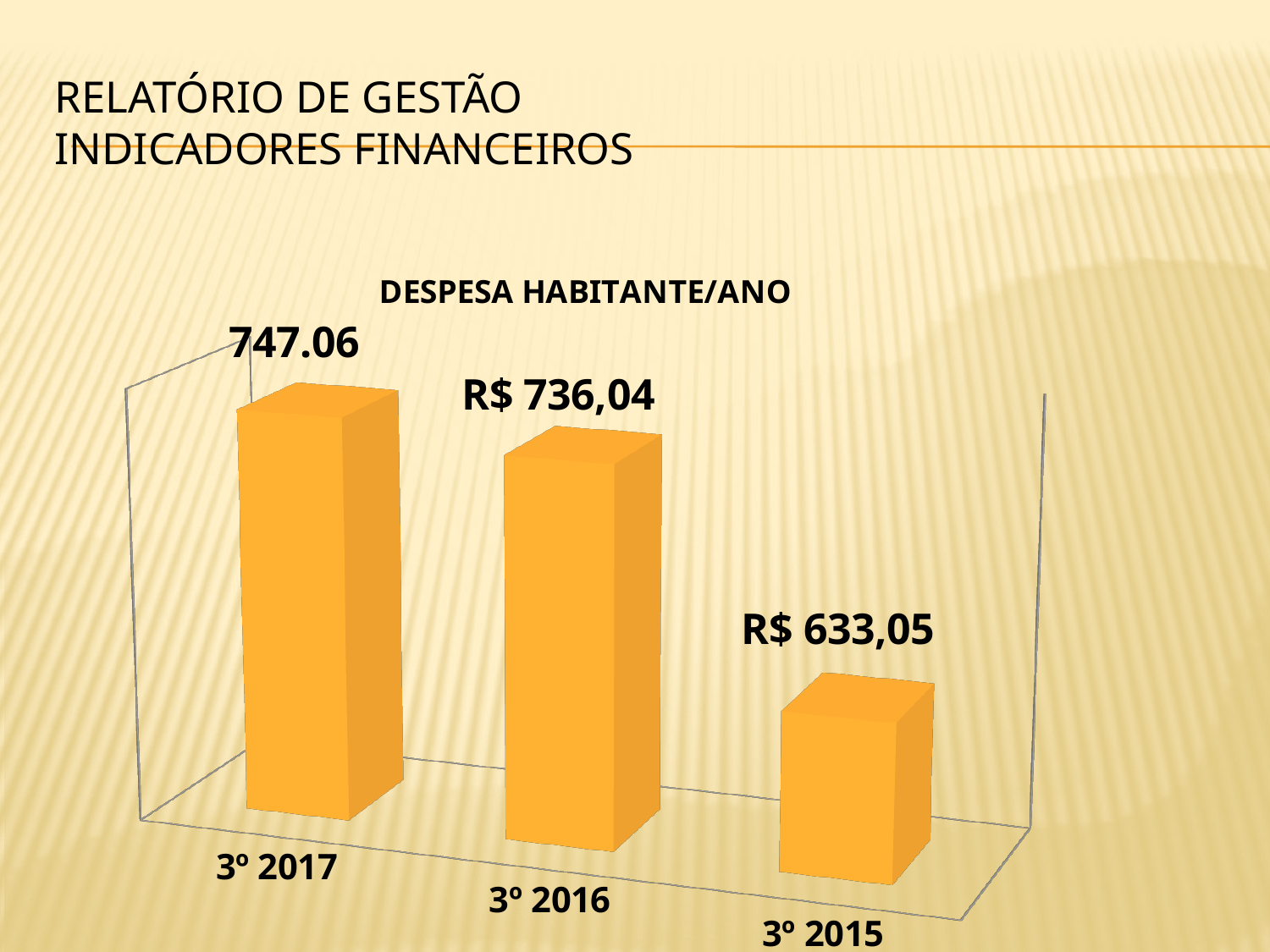
Which category has the highest value? 3º 2017 What is the value shown for 3º 2017? 747.06 What is the difference between the values for 3º 2016 and 3º 2015? R$ 102,99 Which is larger, the value for 3º 2016 or the value for 3º 2015? 3º 2016 Which is larger, the value for 3º 2017 or the value for 3º 2016? 3º 2017 What is the title of the chart? DESPESA HABITANTE/ANO What kind of chart is shown on the slide? Bar chart Which category has the lowest value? 3º 2015 Do the values rise or fall moving left to right along the x axis? Fall What is the value shown for 3º 2016? R$ 736,04 What is the value shown for 3º 2015? R$ 633,05 How many categories are plotted in the chart? 3